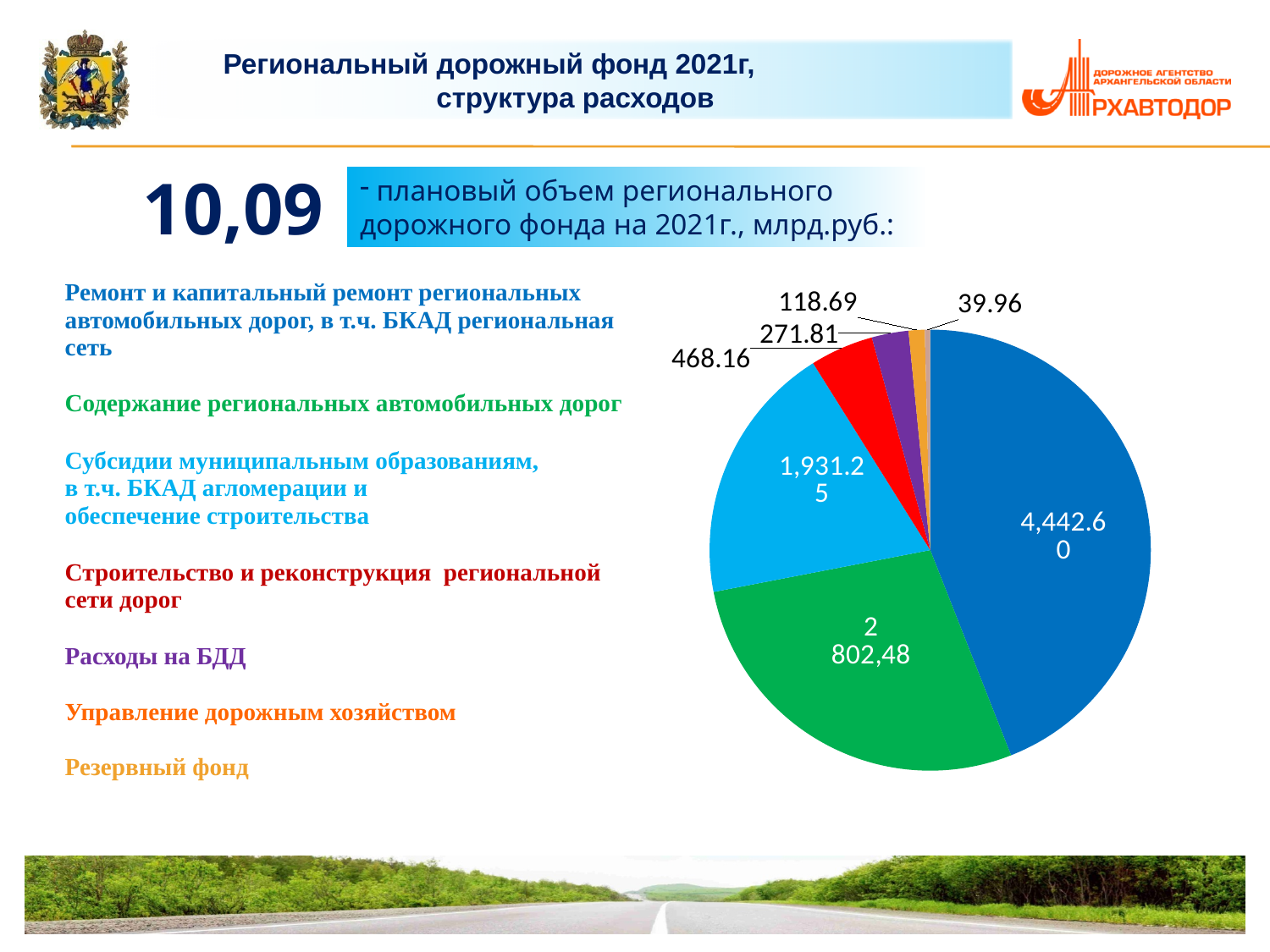
What is the value of the smallest slice of the pie chart? 39.96 How many slices does the pie chart have? 7 What value is shown on the purple slice of the pie chart? 271.81 What is the value of the largest slice of the pie chart? 4,442.60 What is the difference between the orange slice (118.69) and the smallest slice (39.96)? 78.73 Which expense category does the dark blue (largest) slice of the pie chart represent? Ремонт и капитальный ремонт региональных автомобильных дорог, в т.ч. БКАД региональная сеть What value is shown on the green slice of the pie chart? 2 802,48 What is the difference between the red slice (468.16) and the purple slice (271.81)? 196.35 What kind of chart is shown on the slide? pie chart Which is larger in the pie chart: the red slice (468.16) or the purple slice (271.81)? the red slice (468.16) What value is shown on the red slice of the pie chart? 468.16 What value is shown on the light blue slice of the pie chart? 1,931.25